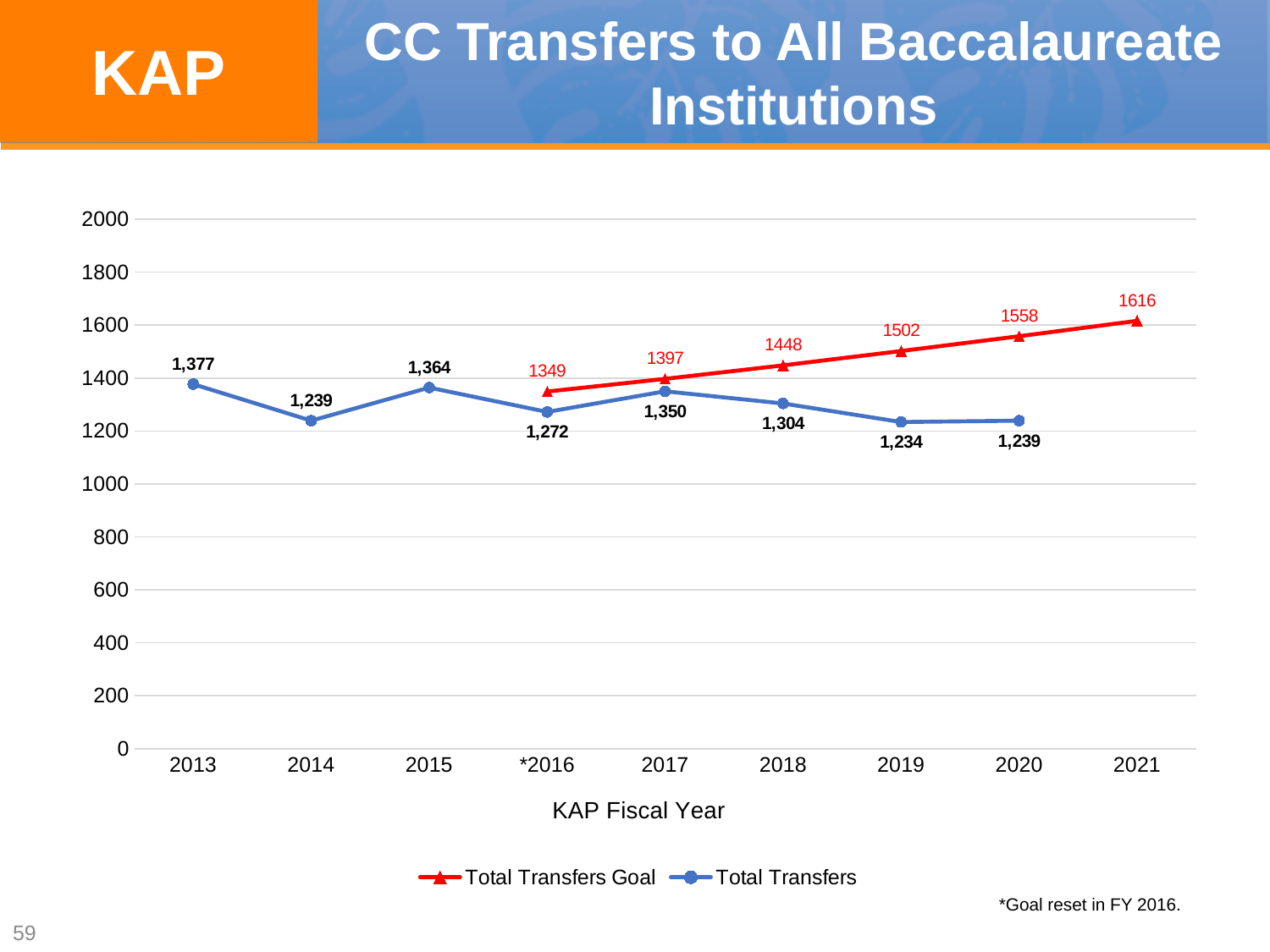
Which year has the lowest Total Transfers value? 2019 What kind of chart is shown on the slide? Line chart In 2017, which is larger: Total Transfers Goal or Total Transfers? Total Transfers Goal How many series does the legend list? 2 How many years are shown on the x axis? 9 What is the Total Transfers value for 2018? 1,304 What is the Total Transfers value for 2013? 1,377 Is the Total Transfers Goal value for 2019 greater or less than 1400? greater What is the Total Transfers Goal value for 2021? 1616 Which year has the highest Total Transfers value? 2013 What is the difference between the Total Transfers Goal and Total Transfers in 2020? 319 What is the Total Transfers Goal value for *2016? 1349